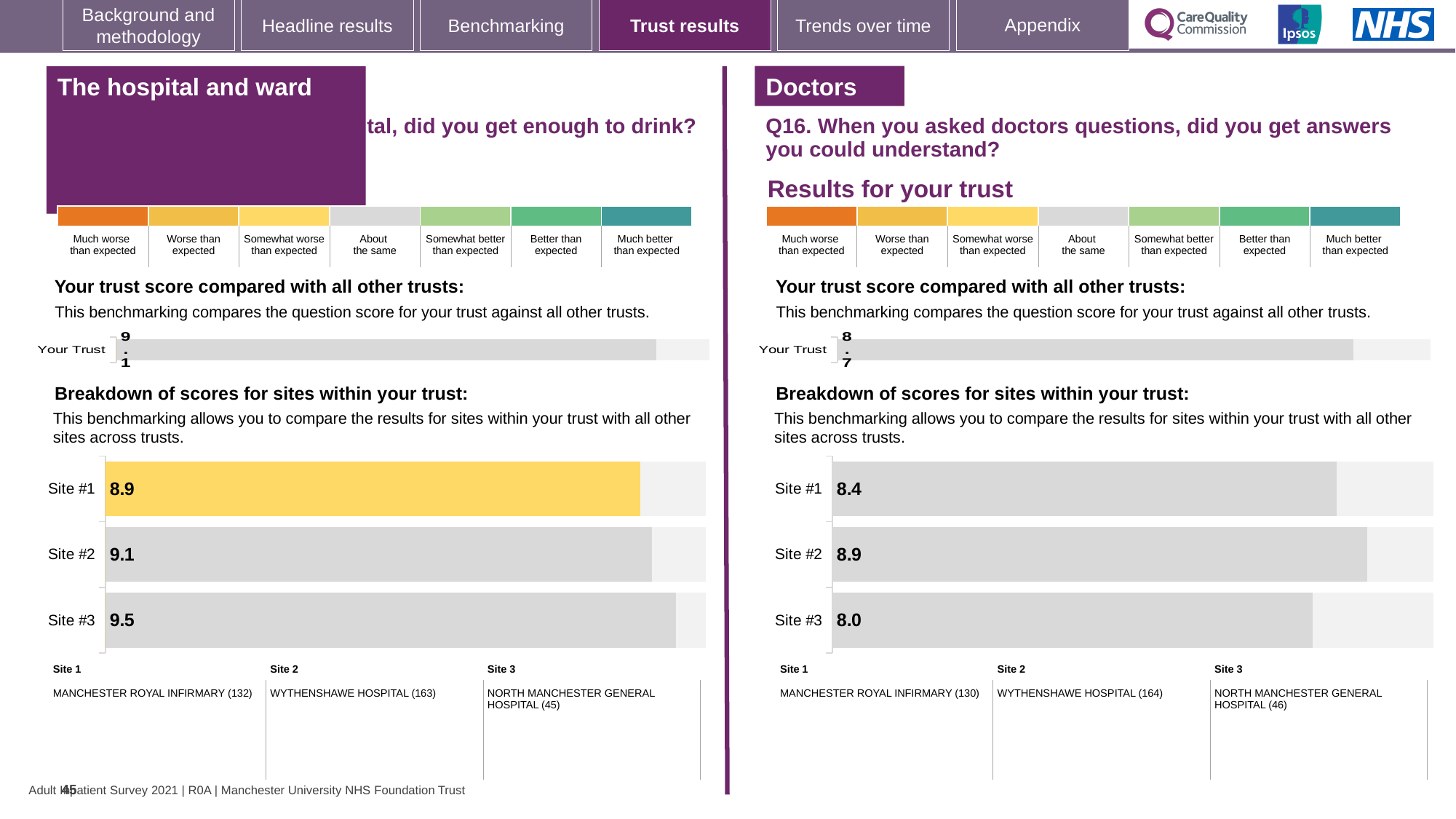
In the Q16 (Doctors) 'Your trust score compared with all other trusts' chart, what is the score for Your Trust? 8.7 What type of chart is used for the site breakdown in the Q16 (Doctors) section? Bar chart In the left-hand site breakdown chart (The hospital and ward section), what is the difference between the scores for Site #3 and Site #1? 0.6 How many sites are shown in the Q16 (Doctors) site breakdown chart? 3 In the left-hand 'Your trust score compared with all other trusts' chart (The hospital and ward section), what is the score for Your Trust? 9.1 In the Q16 (Doctors) site breakdown chart, what is the score for Site #3? 8.0 In the Q16 (Doctors) site breakdown chart, which site has the highest score? Site #2 In the Q16 (Doctors) site breakdown chart, what is the difference between the scores for Site #2 and Site #1? 0.5 In the left-hand site breakdown chart (The hospital and ward section), which site has the highest score? Site #3 Which is larger: the Site #2 score in the left-hand site breakdown chart or the Site #2 score in the Q16 (Doctors) site breakdown chart? The left-hand chart (9.1) In the Q16 (Doctors) site breakdown chart, which site has the lowest score? Site #3 In the left-hand site breakdown chart (The hospital and ward section), what is the score for Site #1? 8.9